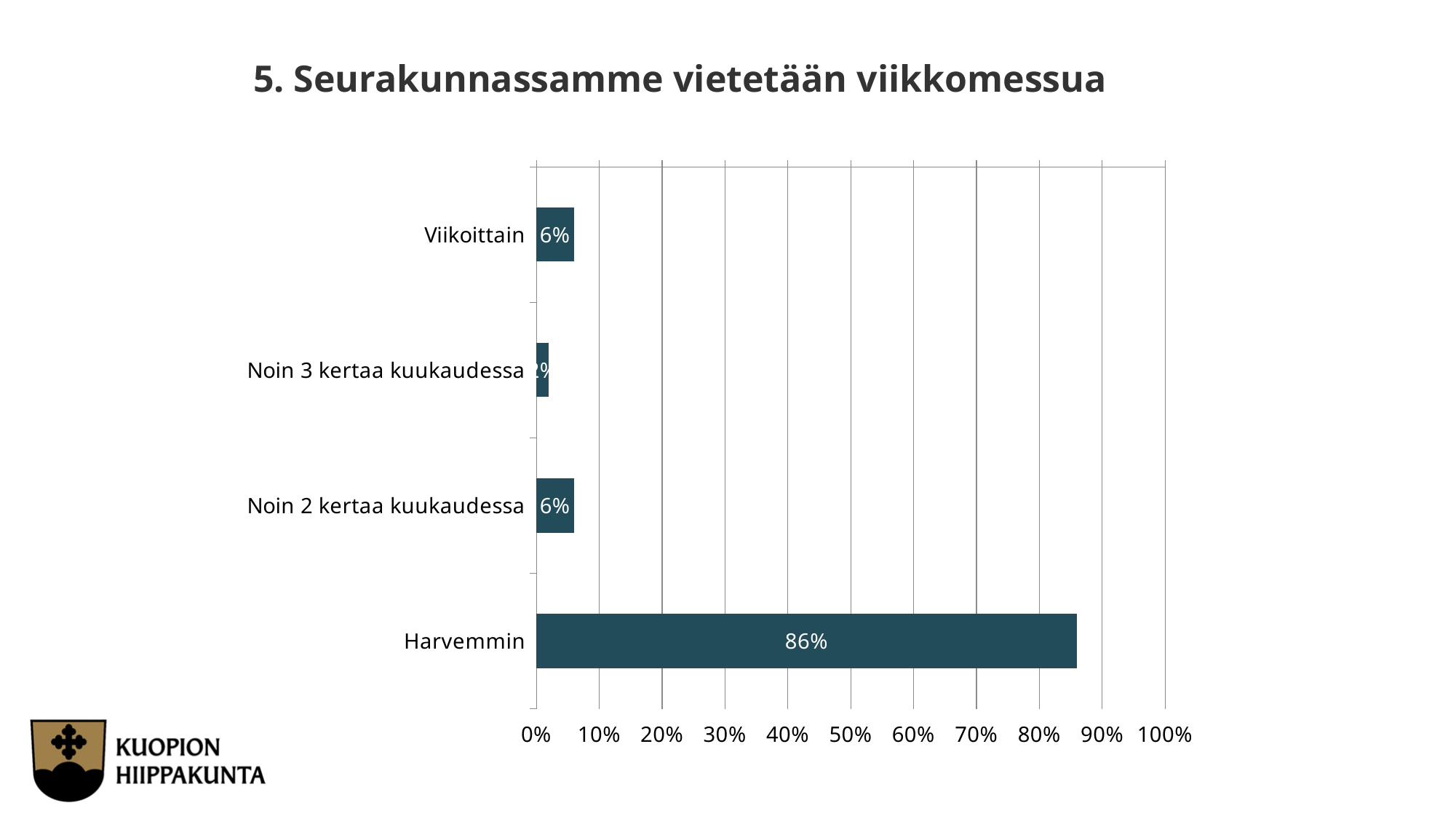
Is the value for Harvemmin greater or less than 80%? greater What is the difference between the values for Harvemmin and Viikoittain? 80 percentage points What kind of chart is shown on the slide? bar chart What is the value for Harvemmin? 86% Which category has the lowest value? Noin 3 kertaa kuukaudessa How many categories are shown in the chart? 4 What is the value for Viikoittain? 6% What is the value for Noin 2 kertaa kuukaudessa? 6% Which is larger, the value for Harvemmin or the value for Noin 2 kertaa kuukaudessa? Harvemmin Which category has the highest value? Harvemmin What is the value for Noin 3 kertaa kuukaudessa? 2% What is the title of the chart? 5. Seurakunnassamme vietetään viikkomessua